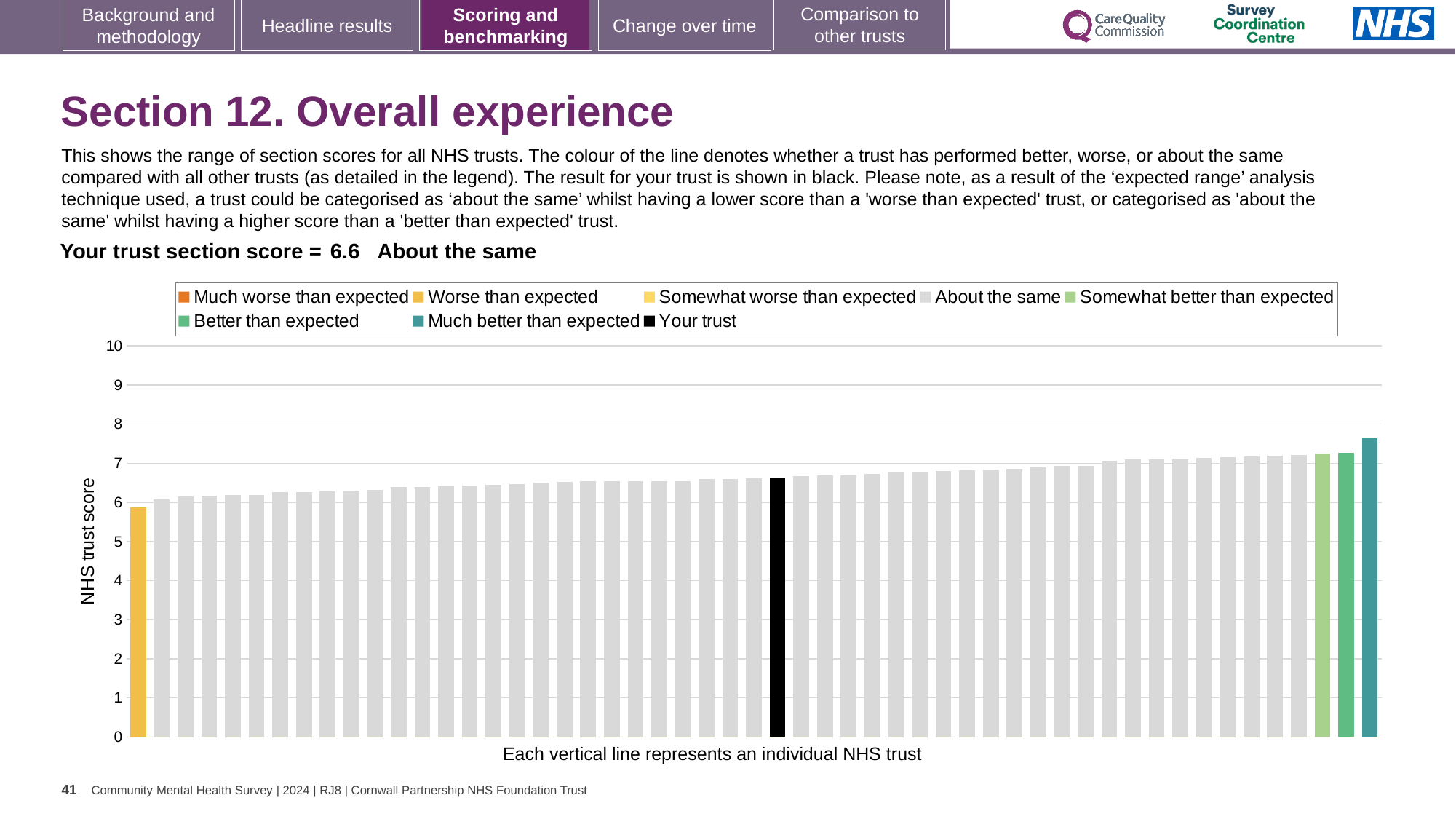
How many entries does the chart legend list? 8 Do the bar values rise or fall from left to right along the x axis? rise Which legend category does the shortest bar belong to? Worse than expected Which legend category does the tallest bar belong to? Much better than expected Is the value of the leftmost bar greater or less than 7? less What is the section score for your trust shown on the slide? 6.6 What is the label on the vertical axis of the chart? NHS trust score Which benchmarking category is your trust placed in for this section? About the same Is the value of the tallest bar greater or less than 7? greater What kind of chart is shown on the slide? bar chart Is the value for your trust greater or less than 5? greater Is the leftmost bar higher or lower than the bar for your trust? lower